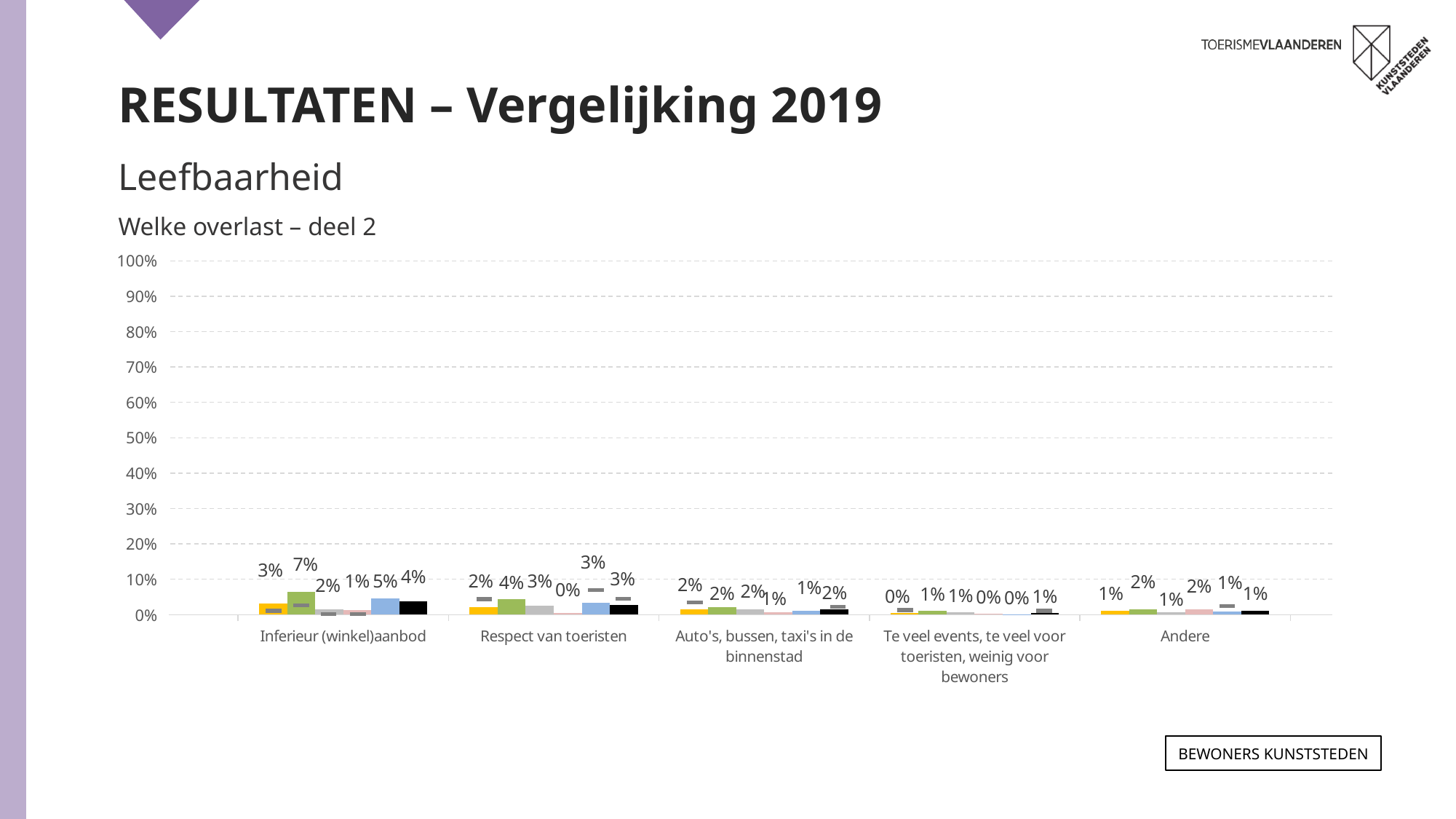
Which is larger for 'Respect van toeristen': the green bar or the yellow bar? the green bar Which category has the highest single bar value in the chart? Inferieur (winkel)aanbod What is the value of the green bar for 'Inferieur (winkel)aanbod'? 7% Is the value of the green bar for 'Inferieur (winkel)aanbod' greater or less than 10%? less What is the value of the blue bar for 'Inferieur (winkel)aanbod'? 5% What is the difference between the green bar and the yellow bar for 'Inferieur (winkel)aanbod'? 4% What kind of chart is shown on the slide? bar chart How many categories are shown on the x axis of the chart? 5 What is the subtitle printed directly above the chart? Welke overlast – deel 2 What is the value of the black bar for 'Respect van toeristen'? 3% How many bars are plotted for each category in the chart? 6 What is the value of the pink bar for 'Respect van toeristen'? 0%